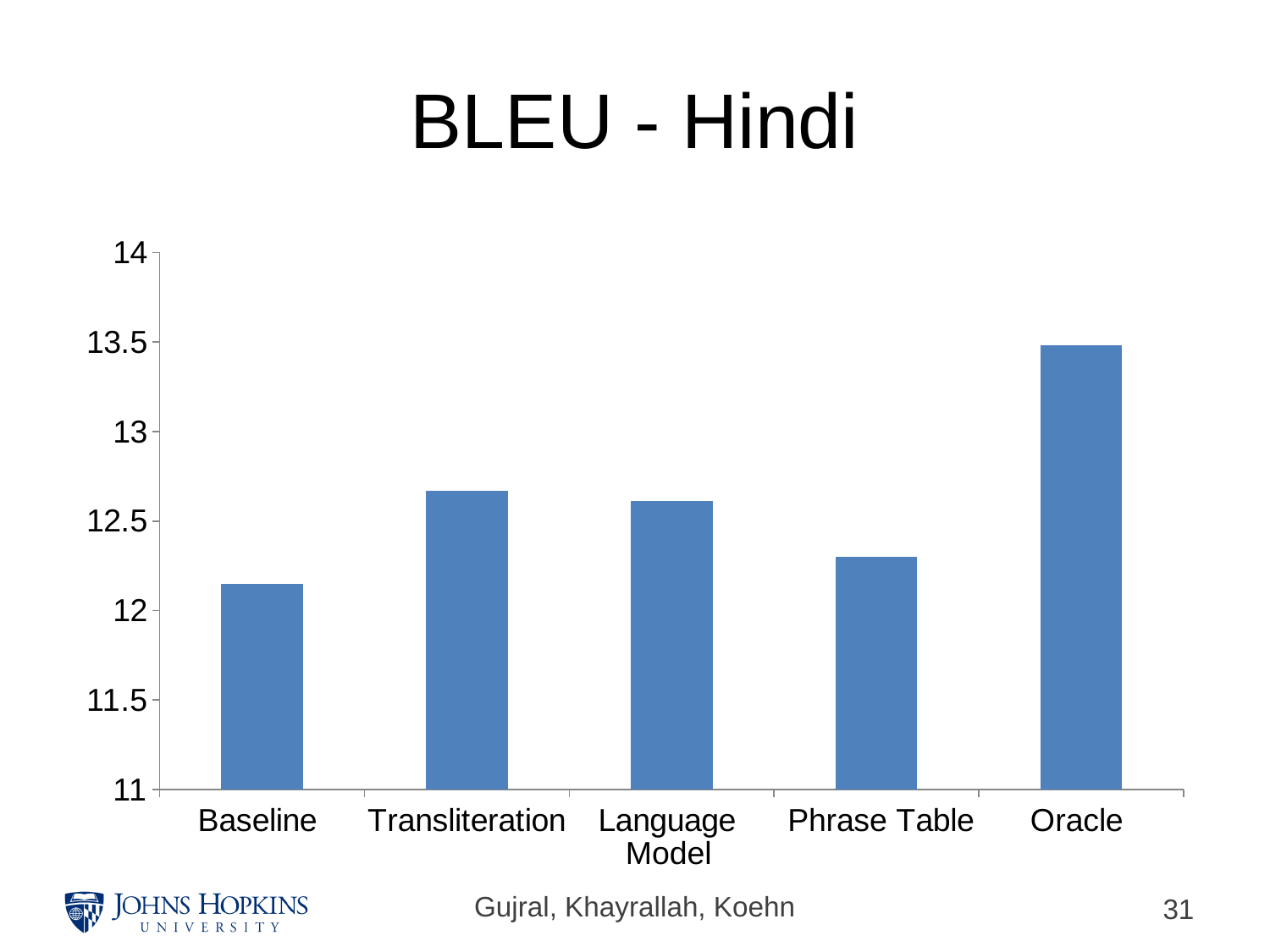
Is the value for Transliteration greater or less than 12.5? greater Which is larger, the value for Transliteration or the value for Phrase Table? Transliteration How many categories are shown on the x axis? 5 Is the value for Phrase Table greater or less than 12.5? less What kind of chart is shown on the slide? bar chart Is the value for Oracle greater or less than 13? greater Which category has the highest value? Oracle Which is larger, the value for Oracle or the value for Language Model? Oracle What is the title of the chart? BLEU - Hindi Which category has the lowest value? Baseline